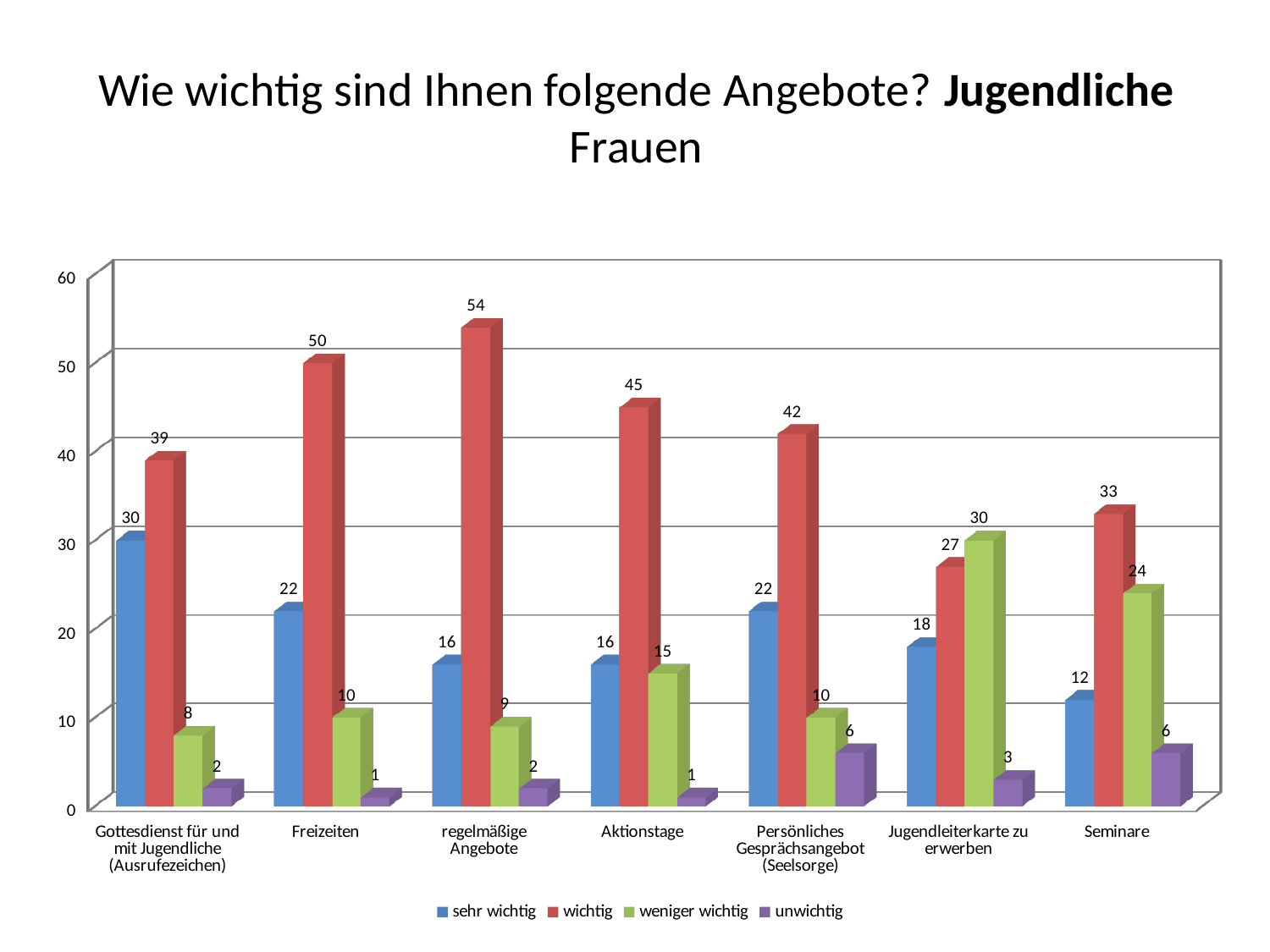
What kind of chart is shown on the slide? bar chart What is the value for "unwichtig" for Seminare? 6 Which category has the lowest value for "sehr wichtig"? Seminare What is the value for "sehr wichtig" for Gottesdienst für und mit Jugendliche (Ausrufezeichen)? 30 Which category has the highest value for "wichtig"? regelmäßige Angebote How many series does the legend list? 4 How many categories are shown on the x axis? 7 What is the value for "wichtig" for Freizeiten? 50 Which series is shown in red? wichtig What is the difference between the "wichtig" and "sehr wichtig" values for Aktionstage? 29 Which is larger for Jugendleiterkarte zu erwerben: "wichtig" or "weniger wichtig"? weniger wichtig What is the value for "weniger wichtig" for Jugendleiterkarte zu erwerben? 30